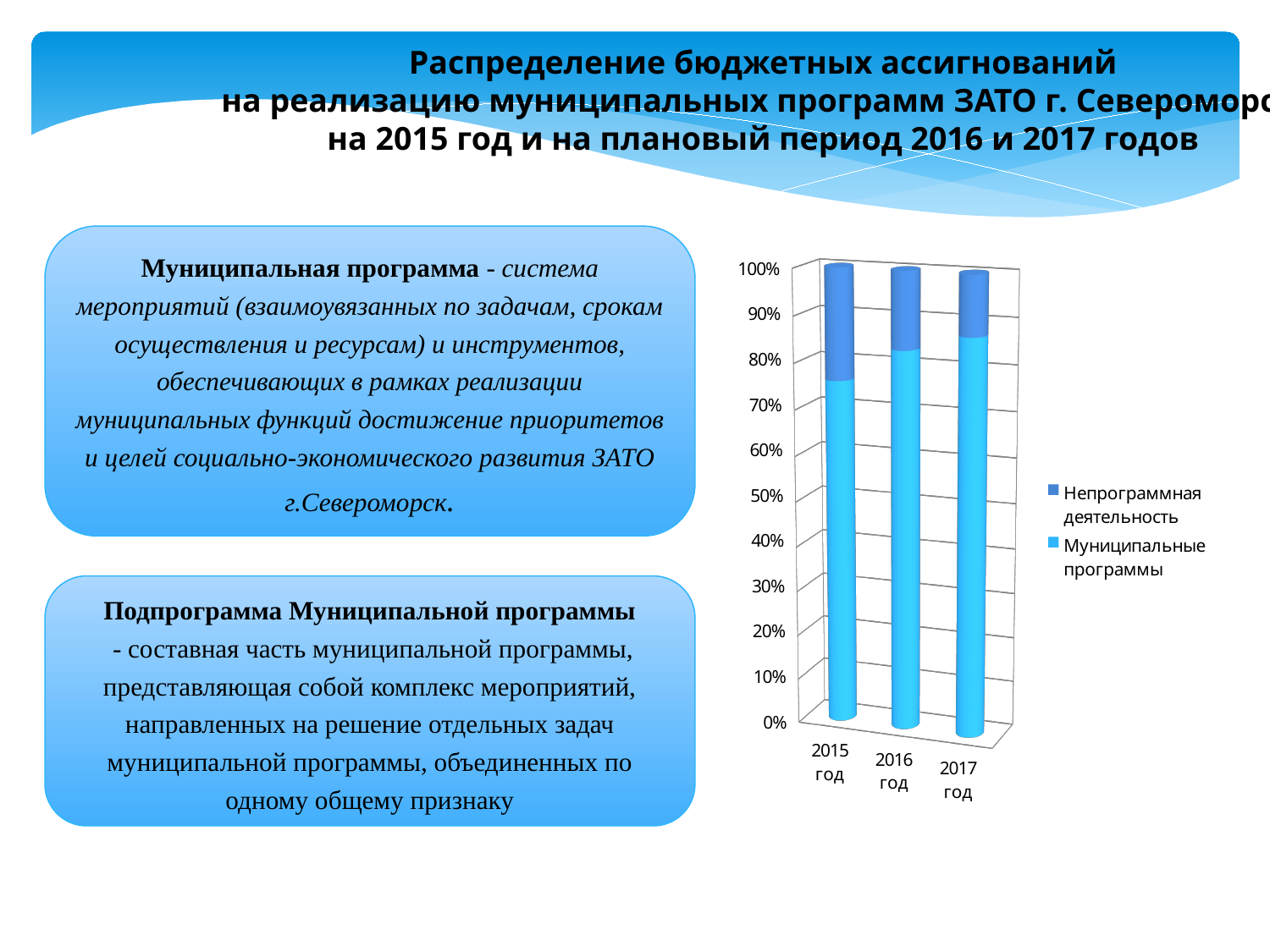
Does the share of Муниципальные программы rise or fall from 2015 to 2017? rise Which series is shown in light blue in the chart? Муниципальные программы Is the share of Муниципальные программы in 2017 greater or less than 80%? greater Is the share of Непрограммная деятельность in 2017 greater or less than 20%? less What kind of chart is shown on the slide? stacked bar chart Is the share of Муниципальные программы in 2015 greater or less than 70%? greater In which year is the share of Непрограммная деятельность the highest? 2015 год How many years (categories) are shown on the x axis of the chart? 3 How many series does the chart legend list? 2 Which series is shown in dark blue in the chart? Непрограммная деятельность In which year is the share of Муниципальные программы the lowest? 2015 год